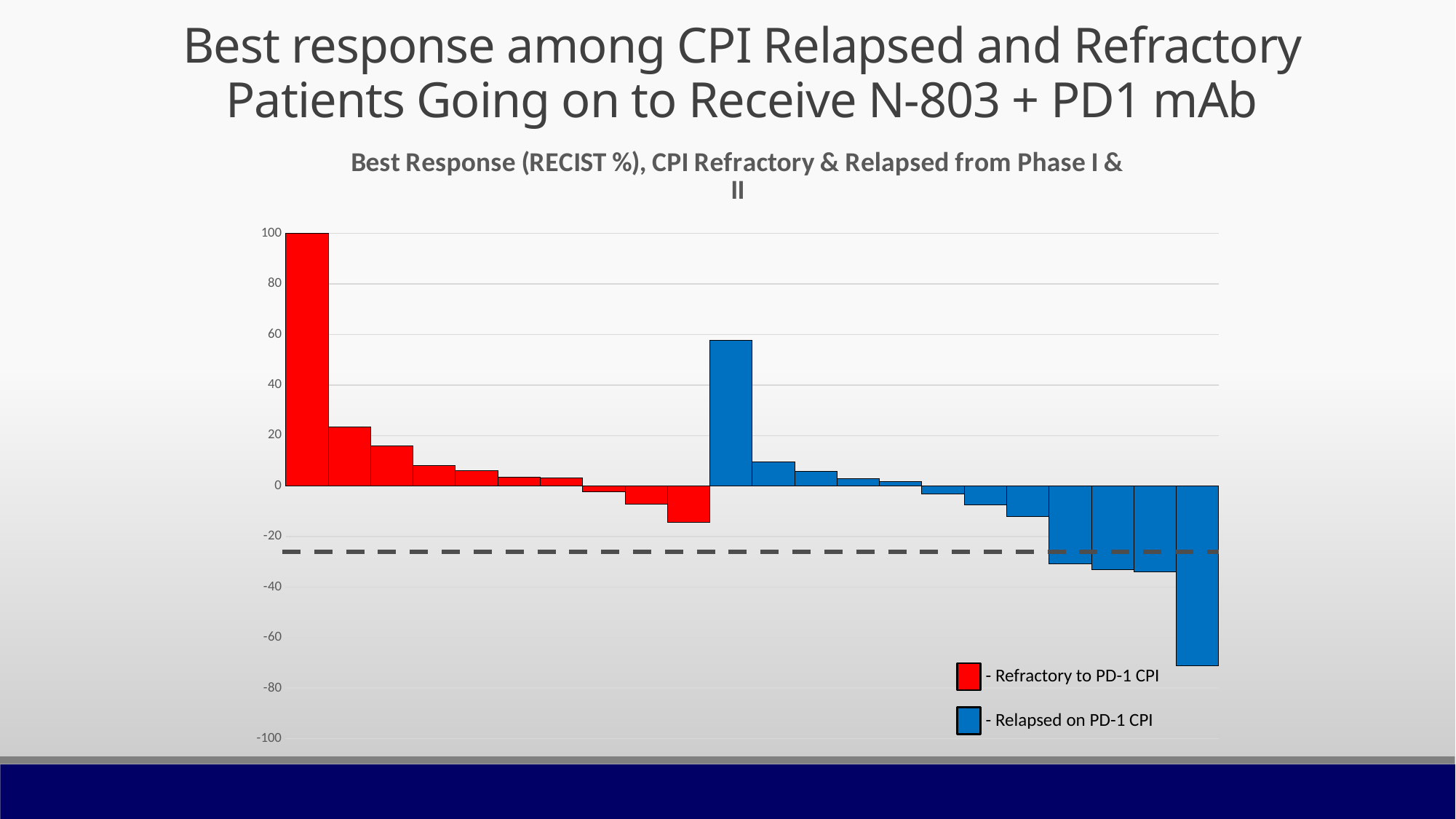
What is the title of the chart? Best Response (RECIST %), CPI Refractory & Relapsed from Phase I & II Is the value of the lowest blue bar greater or less than -60? less Which is larger, the tallest red bar or the tallest blue bar? The tallest red bar Is the value of the tallest blue bar greater or less than 40? greater Within each colour group, do the bar values rise or fall from left to right? Fall How many bars are plotted in the chart in total? 22 How many blue (Relapsed on PD-1 CPI) bars are there? 12 Is the value of the tallest red bar greater or less than 80? greater Which colour represents patients refractory to PD-1 CPI? Red How many series does the legend list? 2 How many red (Refractory to PD-1 CPI) bars are there? 10 What kind of chart is shown on the slide? Bar chart